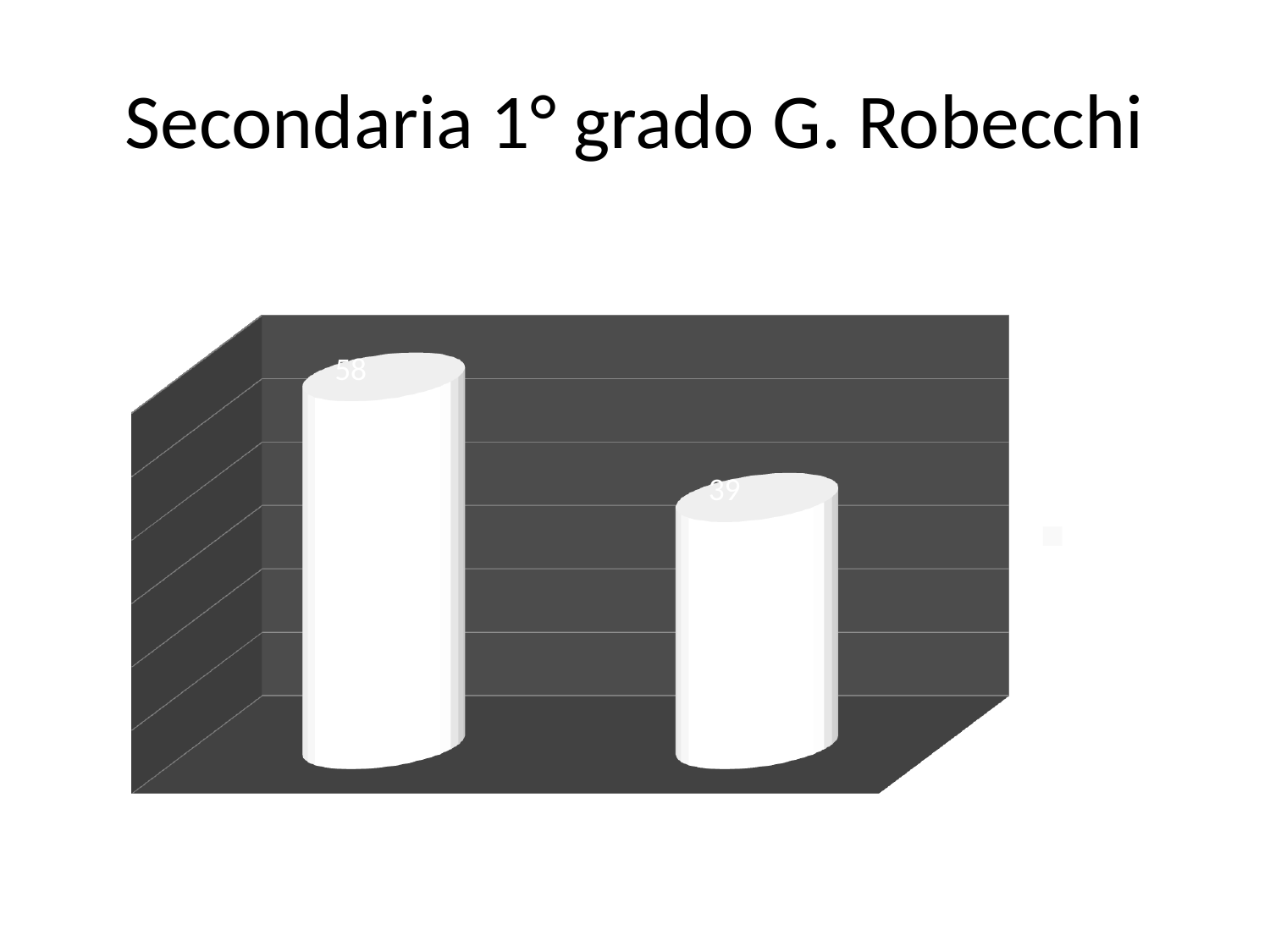
How many bars are plotted in the chart? 2 Which bar has the lower value, the left or the right one? the right bar What value is shown on the right bar of the chart? 39 Do the values rise or fall from the left bar to the right bar? fall Which bar has the higher value, the left or the right one? the left bar What kind of chart is shown on the slide? bar chart What is the difference between the values of the left bar and the right bar? 19 What value is shown on the left bar of the chart? 58 Is the value of the left bar larger or smaller than the value of the right bar? larger What colour are the bars in the chart? white What is the title of the slide containing the chart? Secondaria 1° grado G. Robecchi